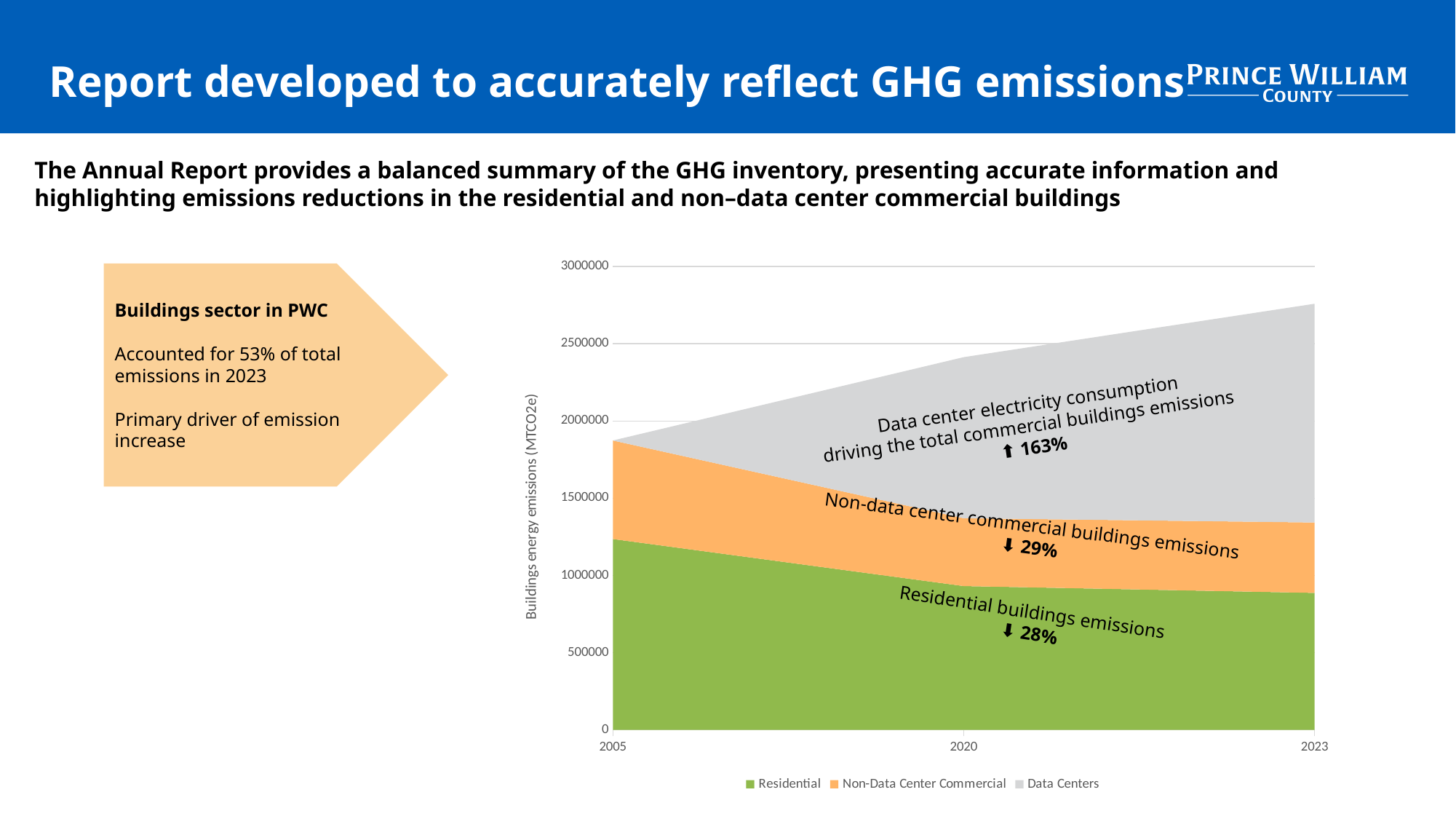
What is the label on the y axis of the chart? Buildings energy emissions (MTCO2e) According to the annotation on the chart, by what percentage did non-data center commercial buildings emissions change? ↓ 29% How many series does the chart legend list? 3 According to the annotation on the chart, by what percentage did data center emissions change? ↑ 163% Do residential buildings emissions rise or fall from 2005 to 2023 in the chart? Fall Is the value for Residential in 2005 greater or less than 1000000? greater Does the total of all three series rise or fall from 2005 to 2023 in the chart? Rise Which series is shown in grey in the chart? Data Centers How many years are labelled on the x axis of the chart? 3 According to the annotation on the chart, by what percentage did residential buildings emissions change? ↓ 28% Is the total stacked value in 2023 greater or less than 2500000? greater What kind of chart is shown on the slide? Stacked area chart